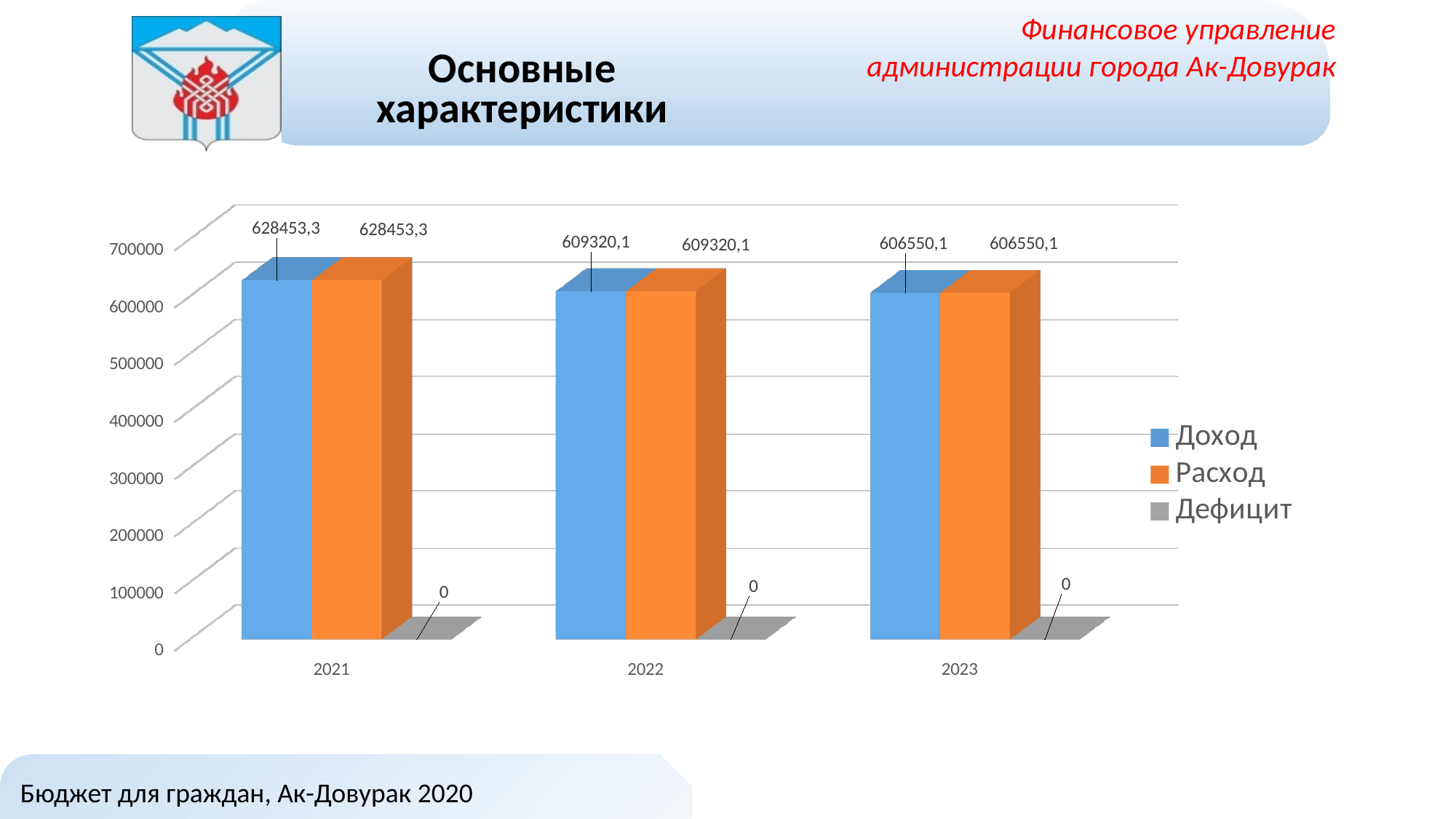
What is the value of Дефицит for 2022? 0 What is the value of Доход for 2023? 606550,1 Which is larger: Доход in 2021 or Доход in 2022? Доход in 2021 What is the value of Расход for 2022? 609320,1 What kind of chart is shown on the slide? Bar chart What is the difference between Доход in 2021 and Доход in 2023? 21903,2 How many years are shown on the x axis? 3 In which year is Доход the highest? 2021 In which year is Расход the lowest? 2023 What is the difference between Расход in 2022 and Расход in 2023? 2770 How many series does the legend list? 3 What is the value of Доход for 2021? 628453,3